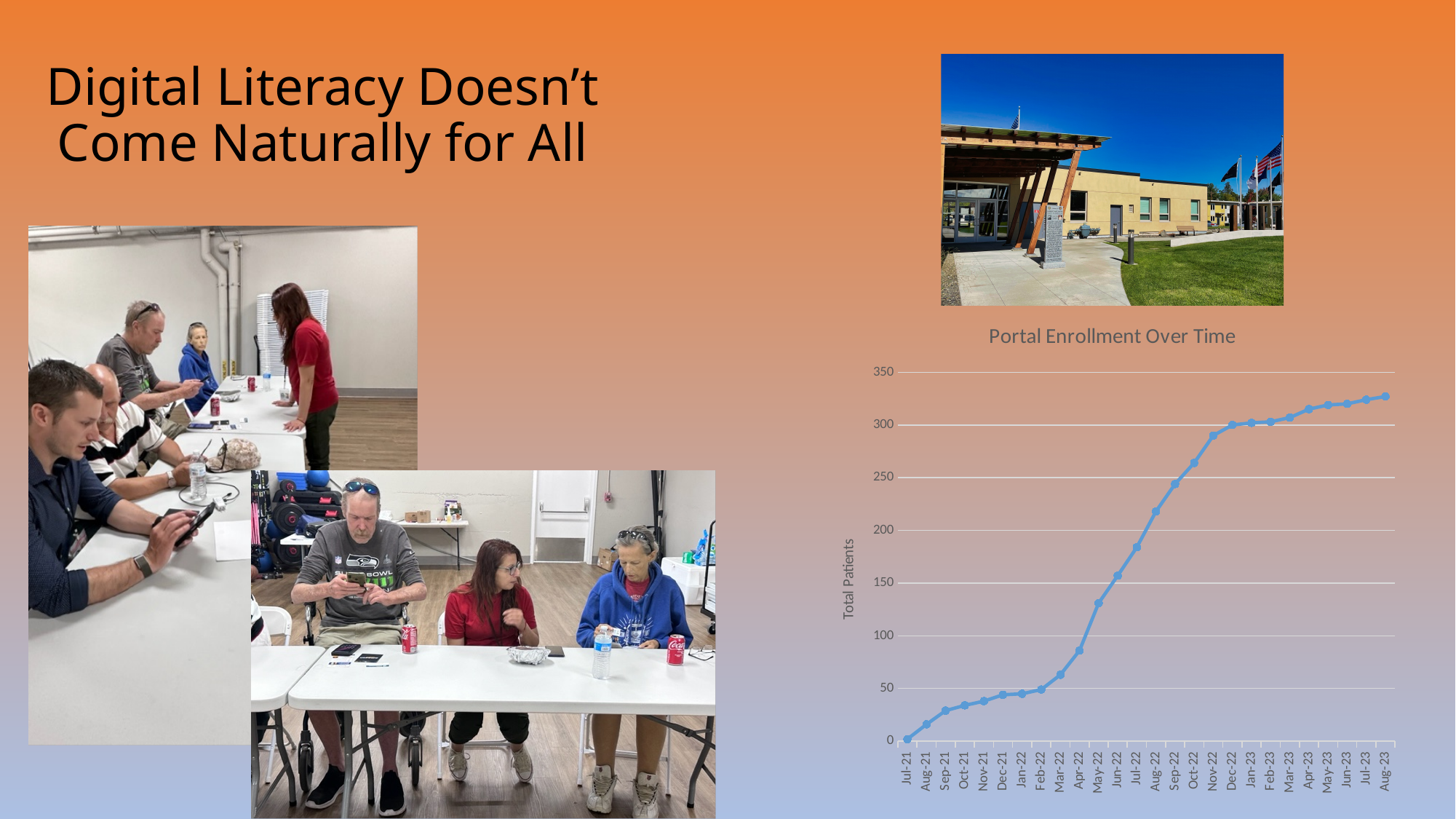
Is the value for Oct-22 greater or less than 250? greater Which is larger, the value for May-22 or the value for Jan-22? May-22 Is the value for Apr-22 greater or less than 100? less Which month has the highest total patients on the chart? Aug-23 What is the label on the vertical axis of the chart? Total Patients Is the value for Aug-23 greater or less than 300? greater How many monthly data points are plotted on the chart? 26 What kind of chart is shown on the slide? line chart What is the title of the chart? Portal Enrollment Over Time Which month has the lowest total patients on the chart? Jul-21 Do the values on the chart rise or fall from Jul-21 to Aug-23? rise